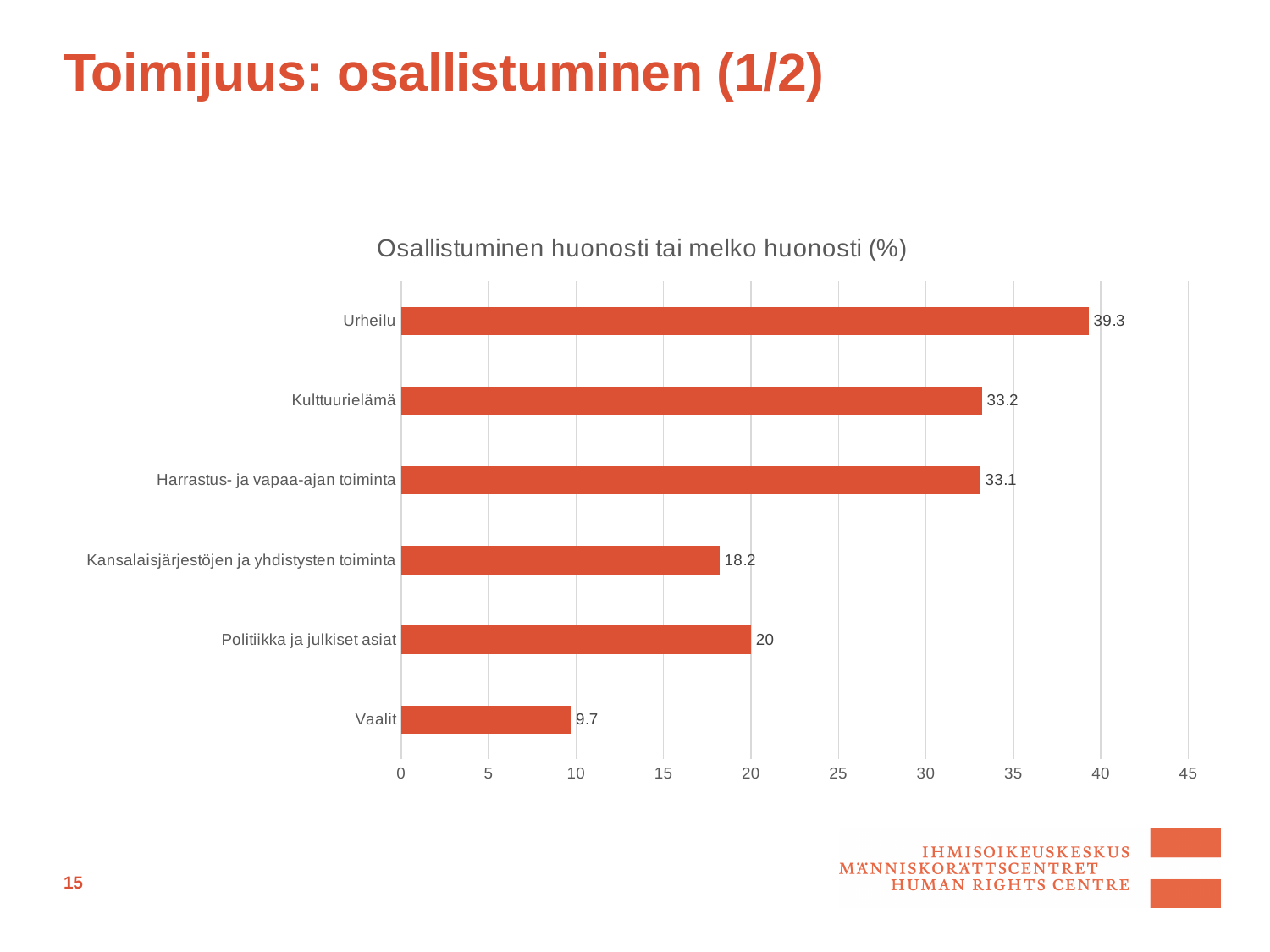
Is the value for Harrastus- ja vapaa-ajan toiminta greater or less than 30? greater Which category has the highest value? Urheilu Which category has the lowest value? Vaalit What is the value for Vaalit? 9.7 Which is larger, the value for Politiikka ja julkiset asiat or the value for Kansalaisjärjestöjen ja yhdistysten toiminta? Politiikka ja julkiset asiat What is the difference between the values for Urheilu and Kulttuurielämä? 6.1 How many categories are shown in the chart? 6 What is the title of the chart? Osallistuminen huonosti tai melko huonosti (%) What is the value for Urheilu? 39.3 What is the value for Politiikka ja julkiset asiat? 20 What kind of chart is shown on the slide? bar chart What is the value for Kansalaisjärjestöjen ja yhdistysten toiminta? 18.2